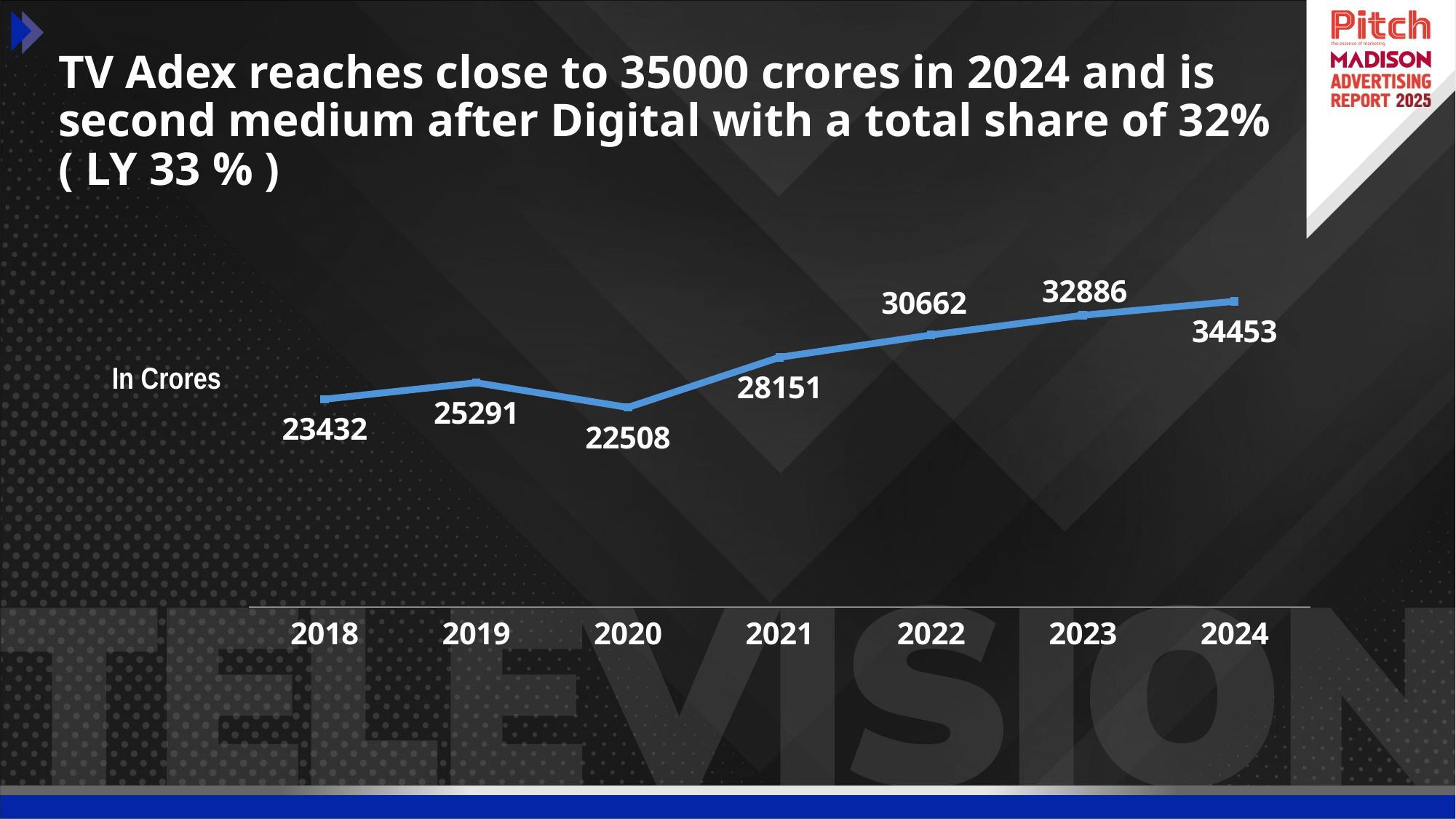
Which year has the highest TV Adex value? 2024 How many years are plotted on the chart? 7 What unit label is shown next to the chart? In Crores What is the difference between the TV Adex values for 2024 and 2023? 1567 What is the TV Adex value for 2018? 23432 What is the difference between the TV Adex values for 2019 and 2020? 2783 Which year has the lowest TV Adex value? 2020 What is the TV Adex value for 2020? 22508 Which year has a larger TV Adex value, 2021 or 2022? 2022 Do the TV Adex values rise or fall from 2020 to 2024? Rise What is the TV Adex value for 2024? 34453 What kind of chart is shown on the slide? Line chart